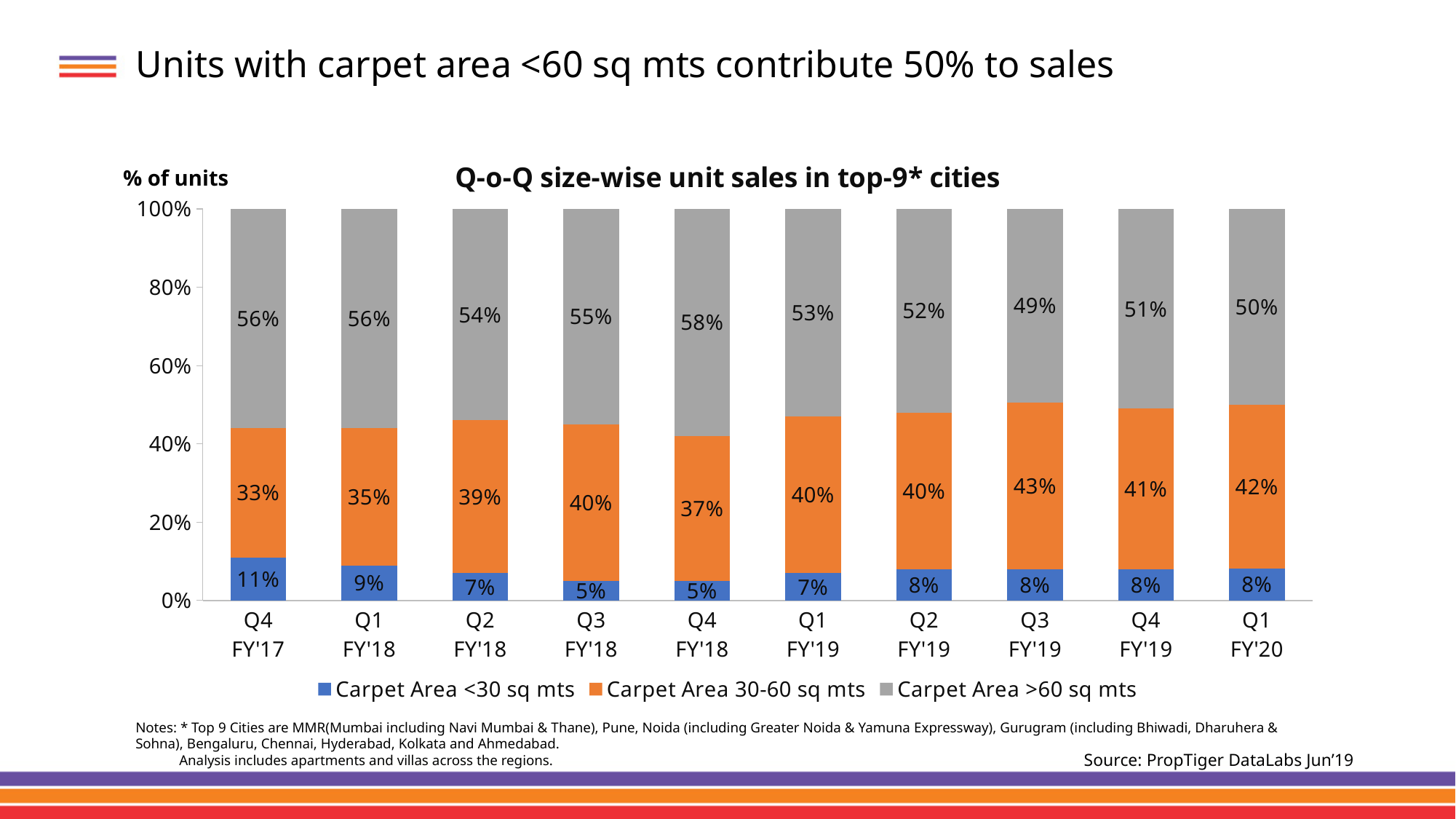
What is the value for Carpet Area <30 sq mts in Q4 FY'17? 11% What is the difference between the Carpet Area 30-60 sq mts values for Q1 FY'20 and Q4 FY'17? 9% Which is larger: the Carpet Area <30 sq mts value in Q4 FY'17 or in Q1 FY'18? Q4 FY'17 What is the value for Carpet Area 30-60 sq mts in Q3 FY'19? 43% What is the title of the chart? Q-o-Q size-wise unit sales in top-9* cities How many quarters are shown on the x axis? 10 Which quarter has the highest value for Carpet Area >60 sq mts? Q4 FY'18 How many series does the legend list? 3 Which quarter has the lowest value for Carpet Area 30-60 sq mts? Q4 FY'17 What is the combined share of Carpet Area <30 sq mts and Carpet Area 30-60 sq mts in Q1 FY'20? 50% What kind of chart is shown? Stacked bar chart What is the value for Carpet Area >60 sq mts in Q4 FY'18? 58%